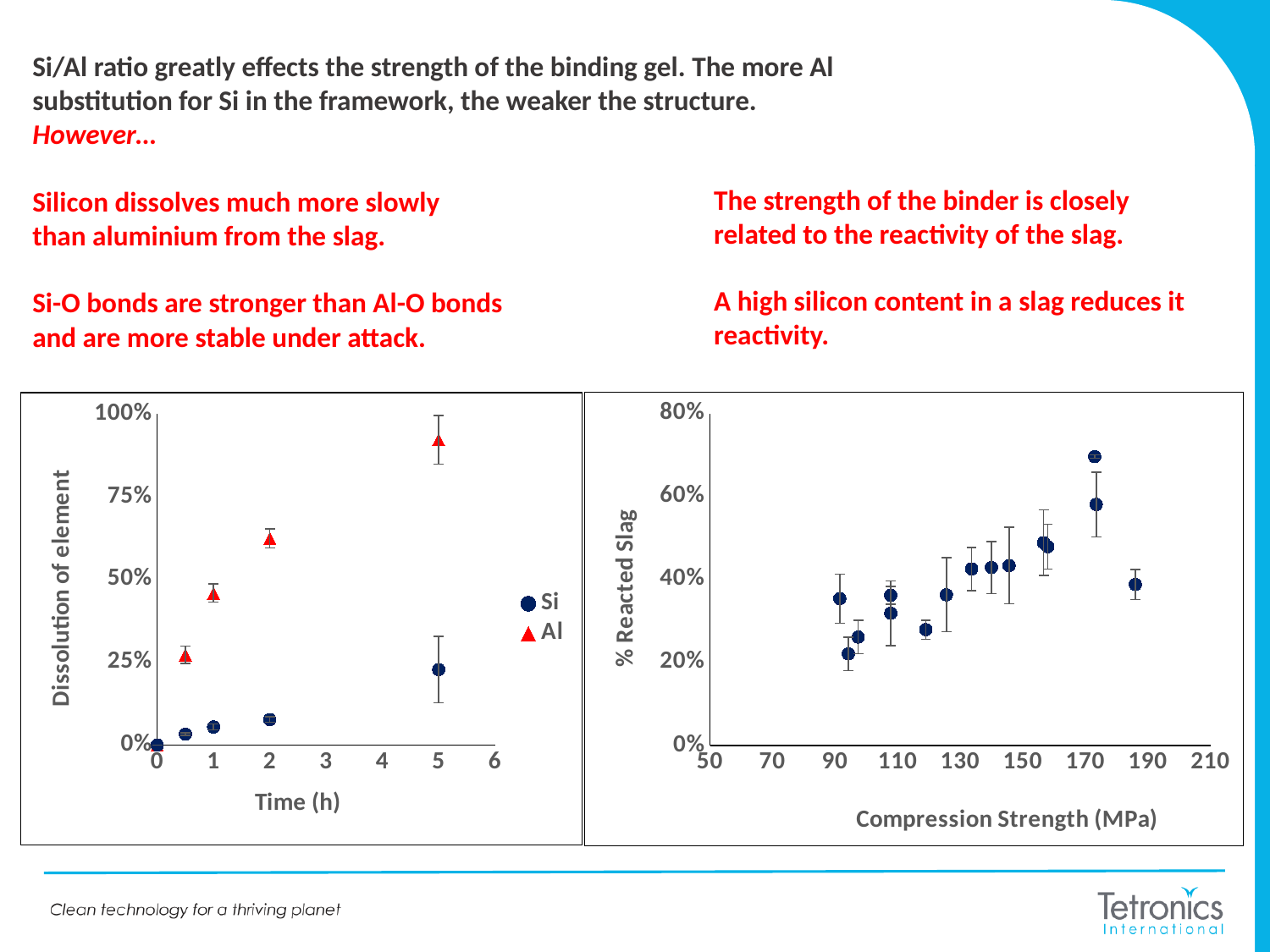
In the right chart, is the highest % Reacted Slag value greater or less than 60%? greater In the left chart, at 5 hours, which series has the higher dissolution, Si or Al? Al In the right chart, does % Reacted Slag generally rise or fall as compression strength increases from 90 to 170 MPa? rise What kind of chart is the right chart (% Reacted Slag vs Compression Strength)? scatter chart What is the x-axis title of the right chart? Compression Strength (MPa) What are the two series named in the legend of the left chart? Si and Al In the left chart, is the Al dissolution at 5 hours greater or less than 75%? greater In the left chart, is the Si dissolution at 5 hours greater or less than 50%? less How many series does the legend of the left chart list? 2 In the left chart, does the Al dissolution rise or fall as time increases? rise What kind of chart is the left chart (Dissolution of element vs Time)? scatter chart